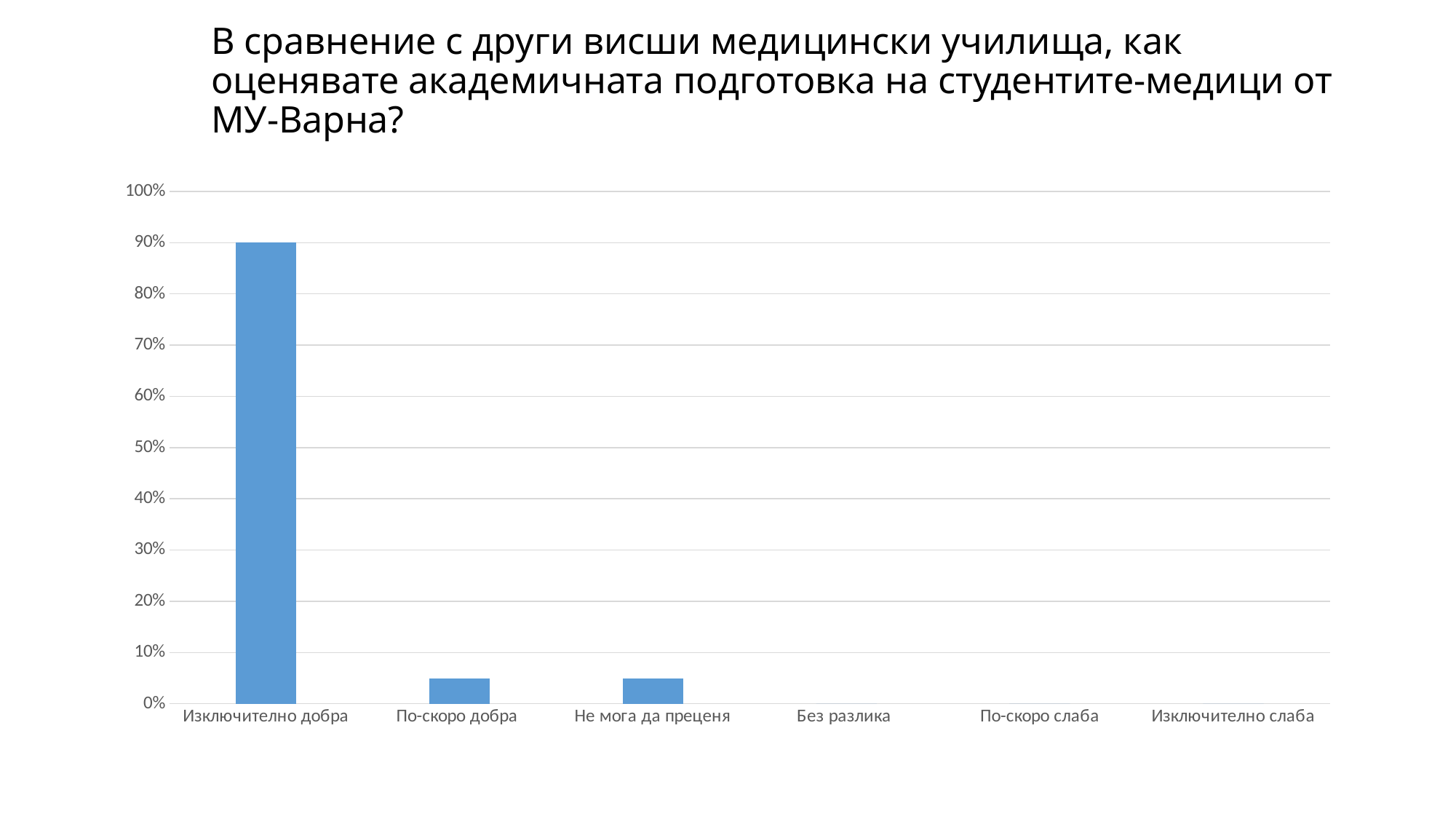
What is the value for Изключително добра? 90% Do the values generally rise or fall from left to right along the x axis? fall How many categories are shown on the x axis of the chart? 6 Which category has the highest value? Изключително добра Which is larger, the value for Изключително добра or the value for По-скоро добра? Изключително добра Which is larger, the value for Изключително добра or the value for Без разлика? Изключително добра What is the highest value shown on the y axis? 100% Is the value for Изключително добра greater or less than 80%? greater What kind of chart is shown on the slide? bar chart Is the value for По-скоро добра greater or less than 10%? less What colour are the bars in the chart? blue Is the value for Не мога да преценя greater or less than 10%? less